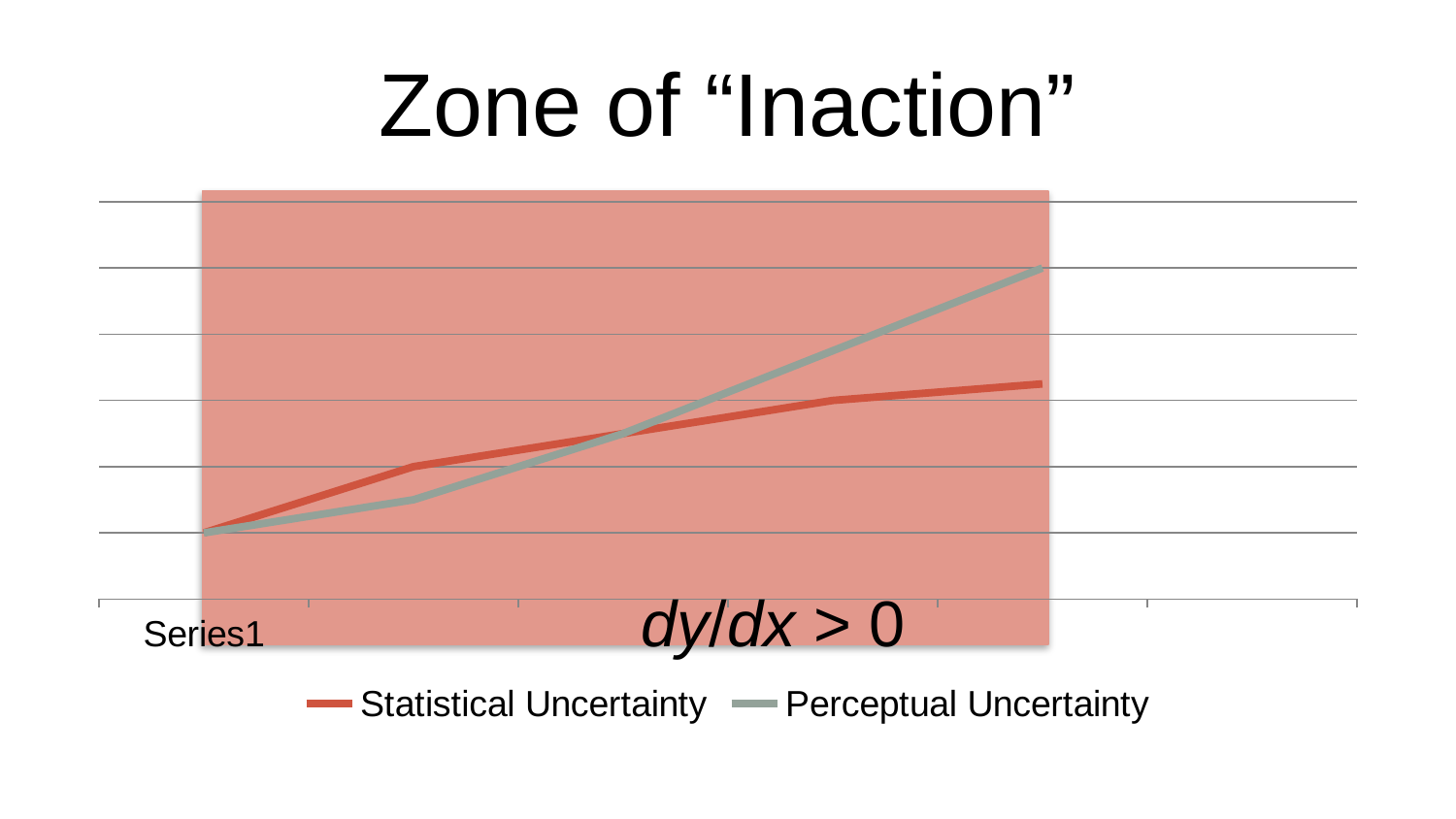
Which series reaches the highest value on the chart? Perceptual Uncertainty What kind of chart is shown on the slide? line chart At the second point from the left, which series is higher: Statistical Uncertainty or Perceptual Uncertainty? Statistical Uncertainty Which series rises more steeply over the right half of the chart? Perceptual Uncertainty How many series does the legend list? 2 Does the Statistical Uncertainty line rise or fall from left to right? rise Does the Perceptual Uncertainty line rise or fall from left to right? rise At the right end of the chart, which series is higher: Statistical Uncertainty or Perceptual Uncertainty? Perceptual Uncertainty What annotation is written along the bottom of the shaded area of the chart? dy/dx > 0 What is the title of the slide's chart? Zone of "Inaction"